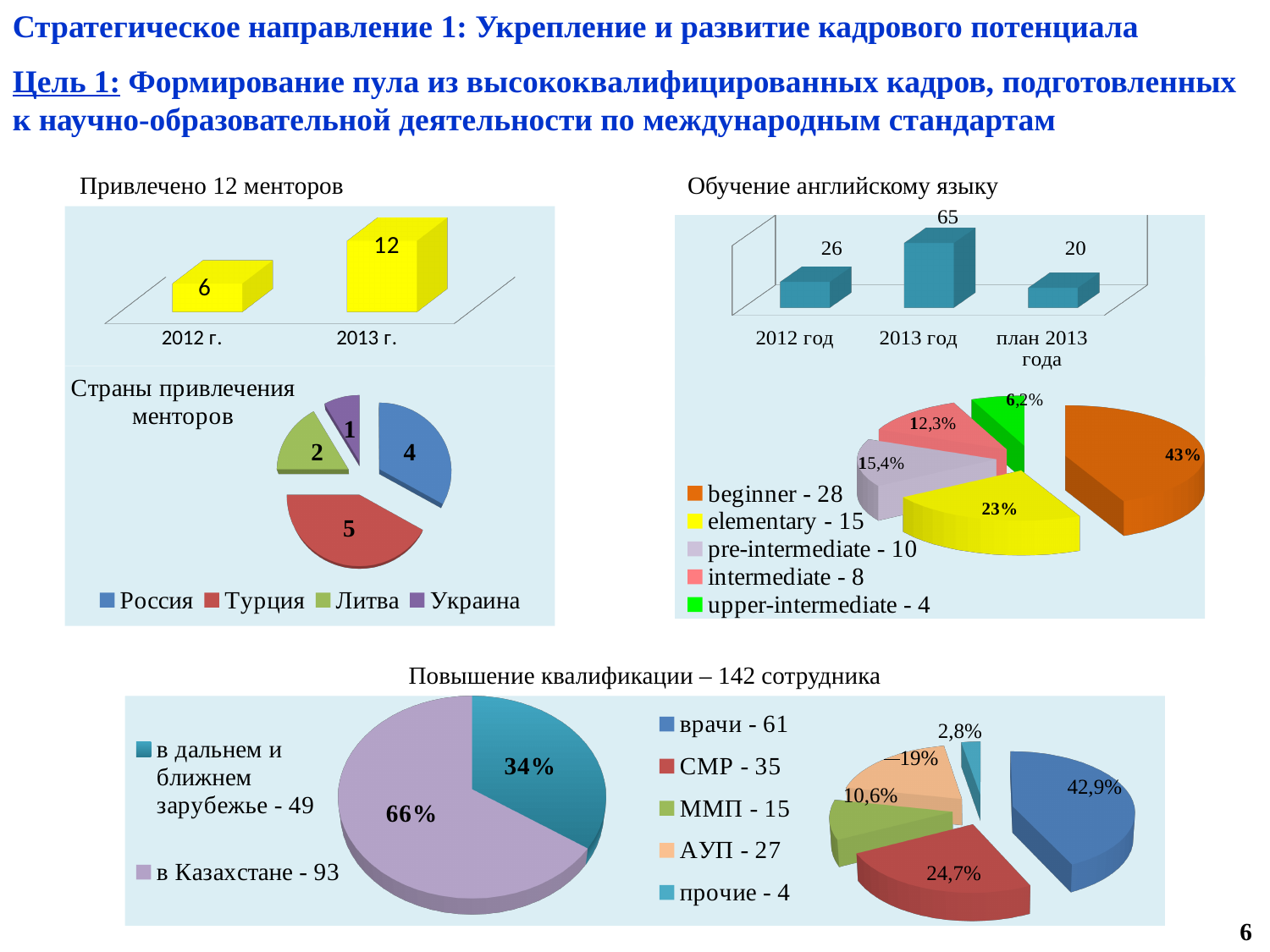
In the English level pie chart on the right, what share does the elementary slice have? 23% In the 'Привлечено 12 менторов' bar chart, what is the value for 2012 г.? 6 In the 'Страны привлечения менторов' pie chart, what is the value for Литва? 2 In the 'Обучение английскому языку' bar chart, what is the value for 2013 год? 65 In the English level pie chart on the right, how many people are at the pre-intermediate level according to the legend? 10 In the 'Повышение квалификации – 142 сотрудника' pie chart on the left, what share is 'в Казахстане'? 66% What type of chart is used for 'Обучение английскому языку' at the top right? Bar chart In the 'Обучение английскому языку' bar chart, which category has the lowest value? план 2013 года In the 'Страны привлечения менторов' pie chart, which country has the largest slice? Турция How many entries does the legend of the 'Страны привлечения менторов' pie chart list? 4 In the staff category pie chart at the bottom right, which category has the smallest slice? прочие In the 'Привлечено 12 менторов' bar chart, what is the difference between the 2013 г. and 2012 г. values? 6